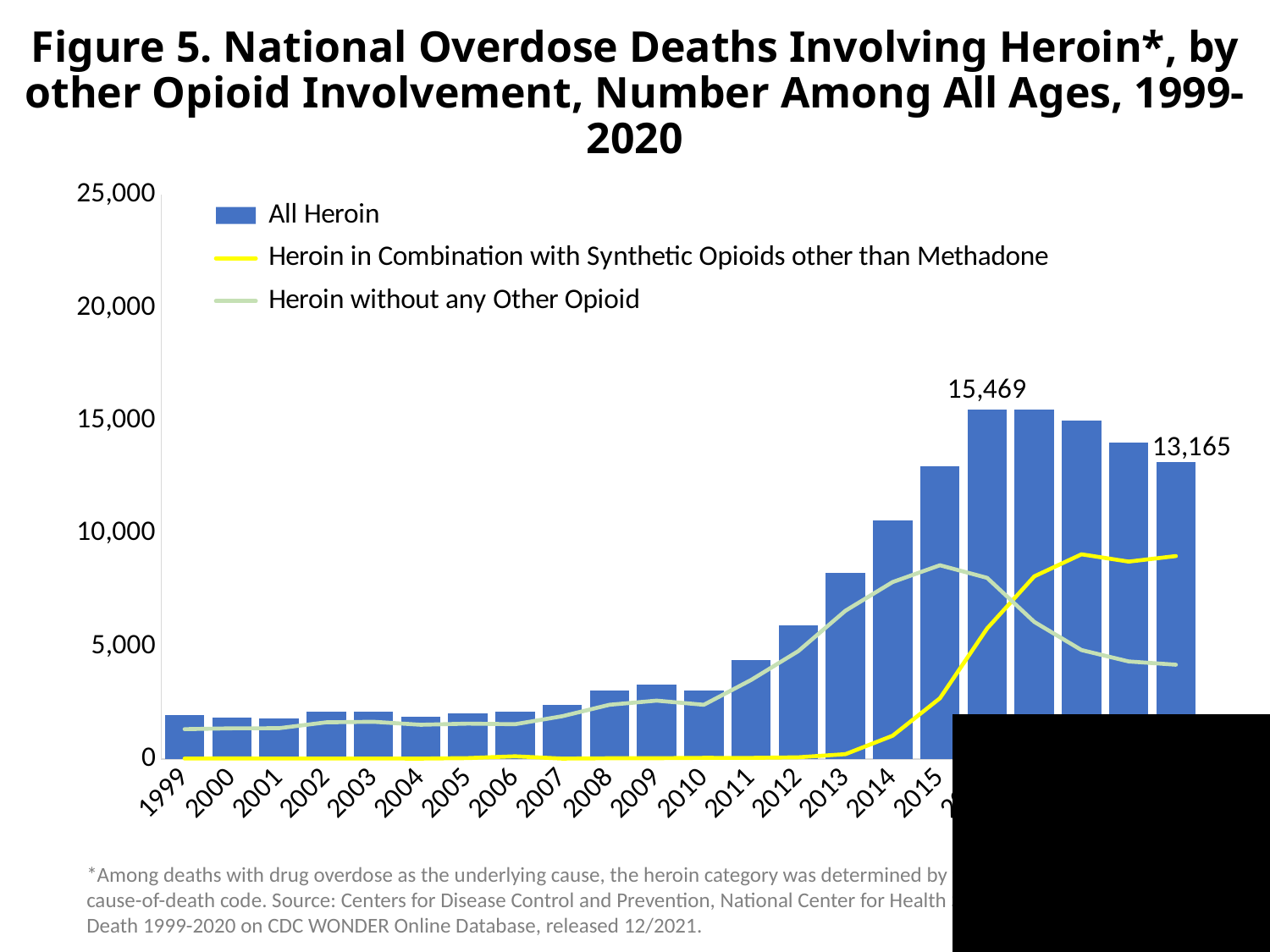
What is the difference between the two printed data labels, 15,469 and 13,165? 2,304 How many series does the legend list? 3 Is the All Heroin value for 2013 greater or less than 5,000? greater Is the All Heroin value for 2011 greater or less than 5,000? less What is the data label printed on the rightmost bar (the last year)? 13,165 Is the All Heroin value for 2015 greater or less than 10,000? greater How many bars (years) are plotted in the chart? 22 What is the larger of the two data labels printed on the chart? 15,469 Which series is drawn as the yellow line? Heroin in Combination with Synthetic Opioids other than Methadone What kind of chart is shown on the slide? A bar chart combined with line series Do the All Heroin bars rise or fall from 1999 to 2015? rise In 2013, which series is higher: Heroin without any Other Opioid or Heroin in Combination with Synthetic Opioids other than Methadone? Heroin without any Other Opioid